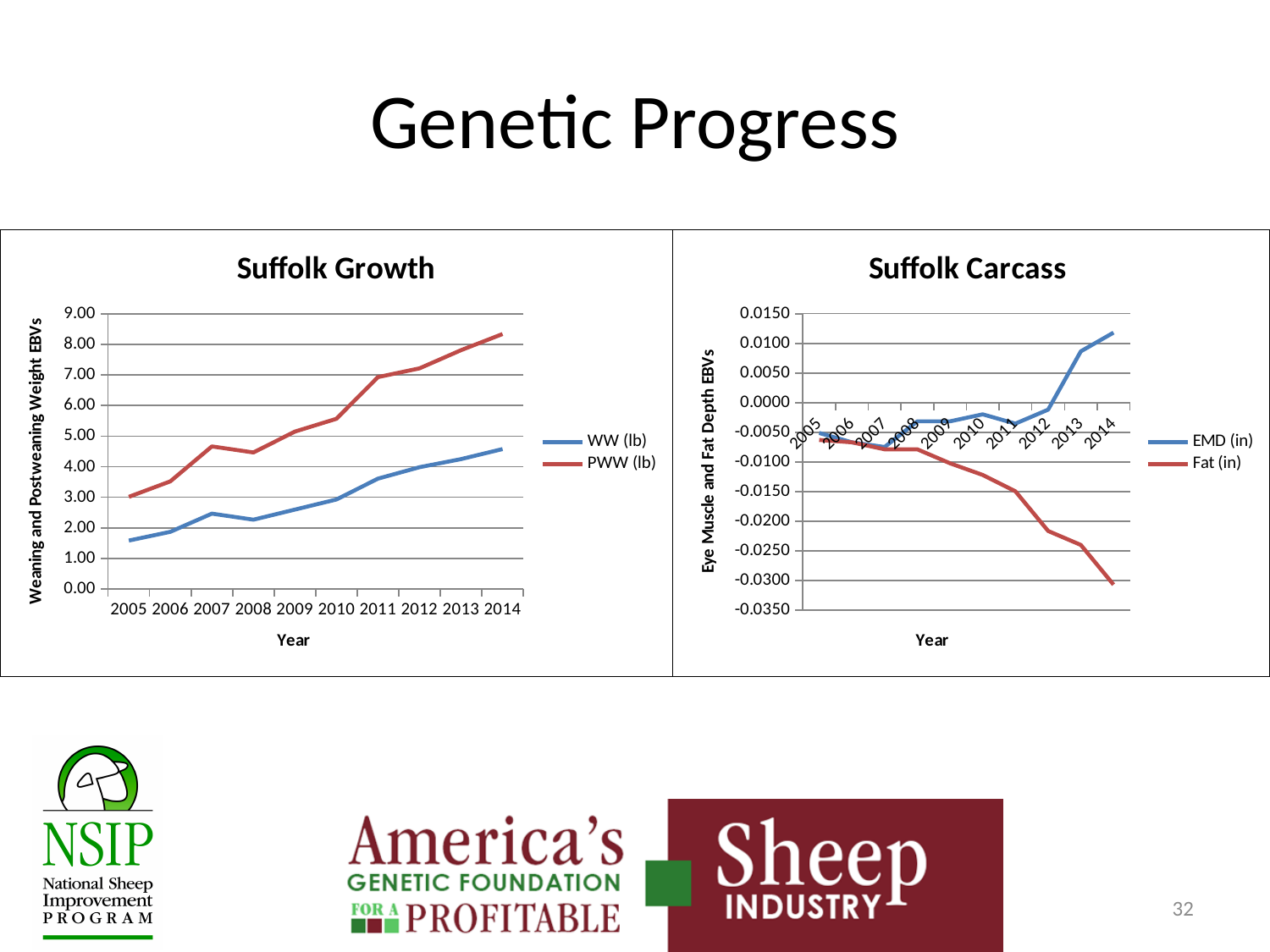
In the Suffolk Carcass chart, is the EMD (in) value for 2014 greater or less than 0.0100? greater In the Suffolk Growth chart, which series has the larger value in 2014, WW (lb) or PWW (lb)? PWW (lb) In the Suffolk Growth chart, does the PWW (lb) series rise or fall from 2005 to 2014? rise In the Suffolk Carcass chart, in which year is the Fat (in) value lowest? 2014 In the Suffolk Carcass chart, does the Fat (in) series rise or fall from 2005 to 2014? fall How many series does the legend of the Suffolk Carcass chart list? 2 In the Suffolk Growth chart, is the PWW (lb) value for 2014 greater or less than 8.00? greater What kind of chart is the Suffolk Growth chart? line chart What is the y-axis label of the Suffolk Carcass chart? Eye Muscle and Fat Depth EBVs How many years are plotted on the x axis of the Suffolk Growth chart? 10 In the Suffolk Carcass chart, is the Fat (in) value for 2014 greater or less than -0.0250? less